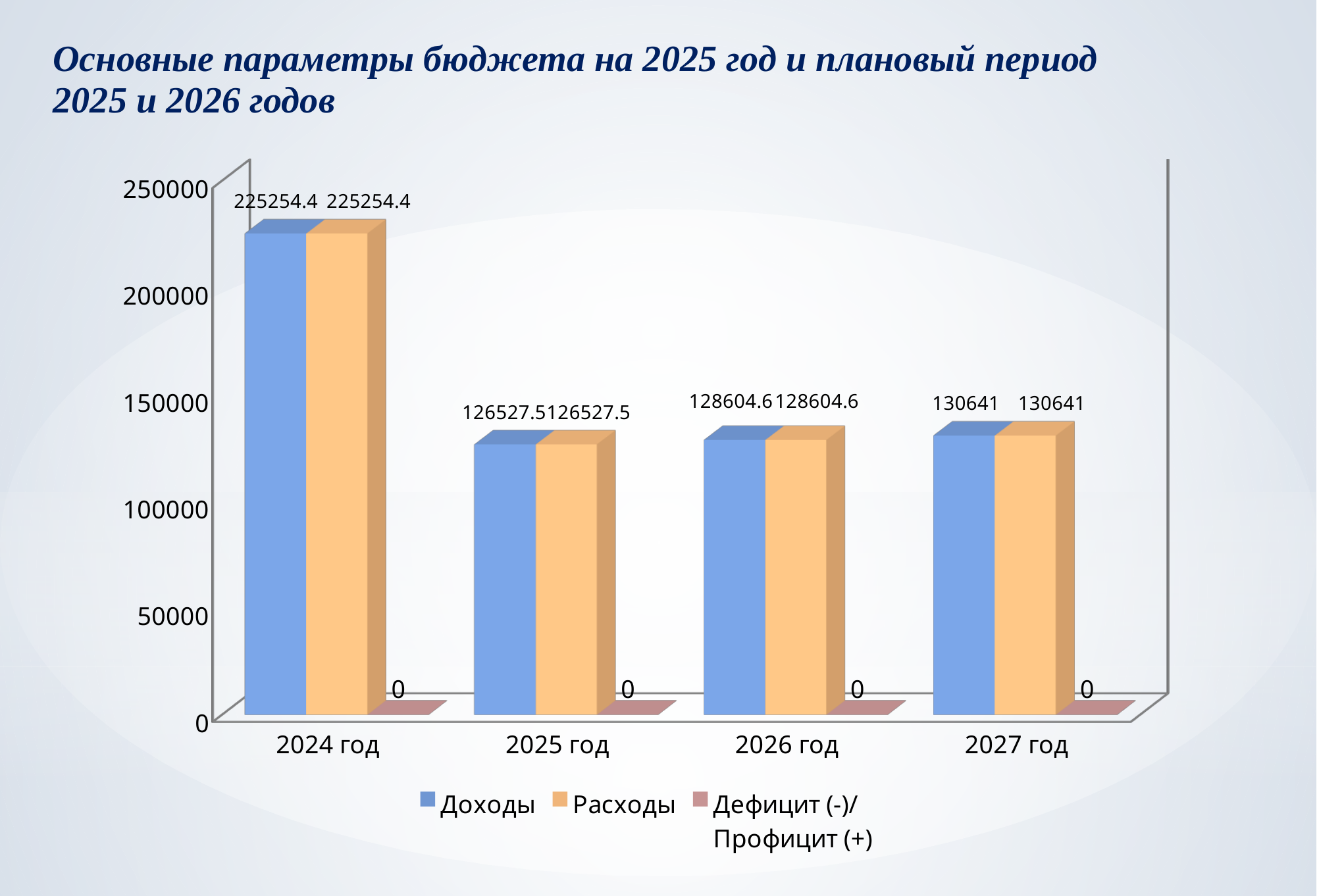
How many series does the legend list? 3 Which year has the lowest value of Расходы? 2025 год What is the value of Доходы for 2024 год? 225254.4 What is the difference between Доходы for 2024 год and Доходы for 2025 год? 98726.9 What is the value of Расходы for 2025 год? 126527.5 Which is larger: Расходы for 2027 год or Расходы for 2026 год? 2027 год How many year categories are shown on the x axis? 4 Which year has the highest value of Доходы? 2024 год What is the value of Доходы for 2026 год? 128604.6 What is the value of Расходы for 2027 год? 130641 What is the value of Дефицит (-)/Профицит (+) for 2025 год? 0 What kind of chart is shown on the slide? Bar chart